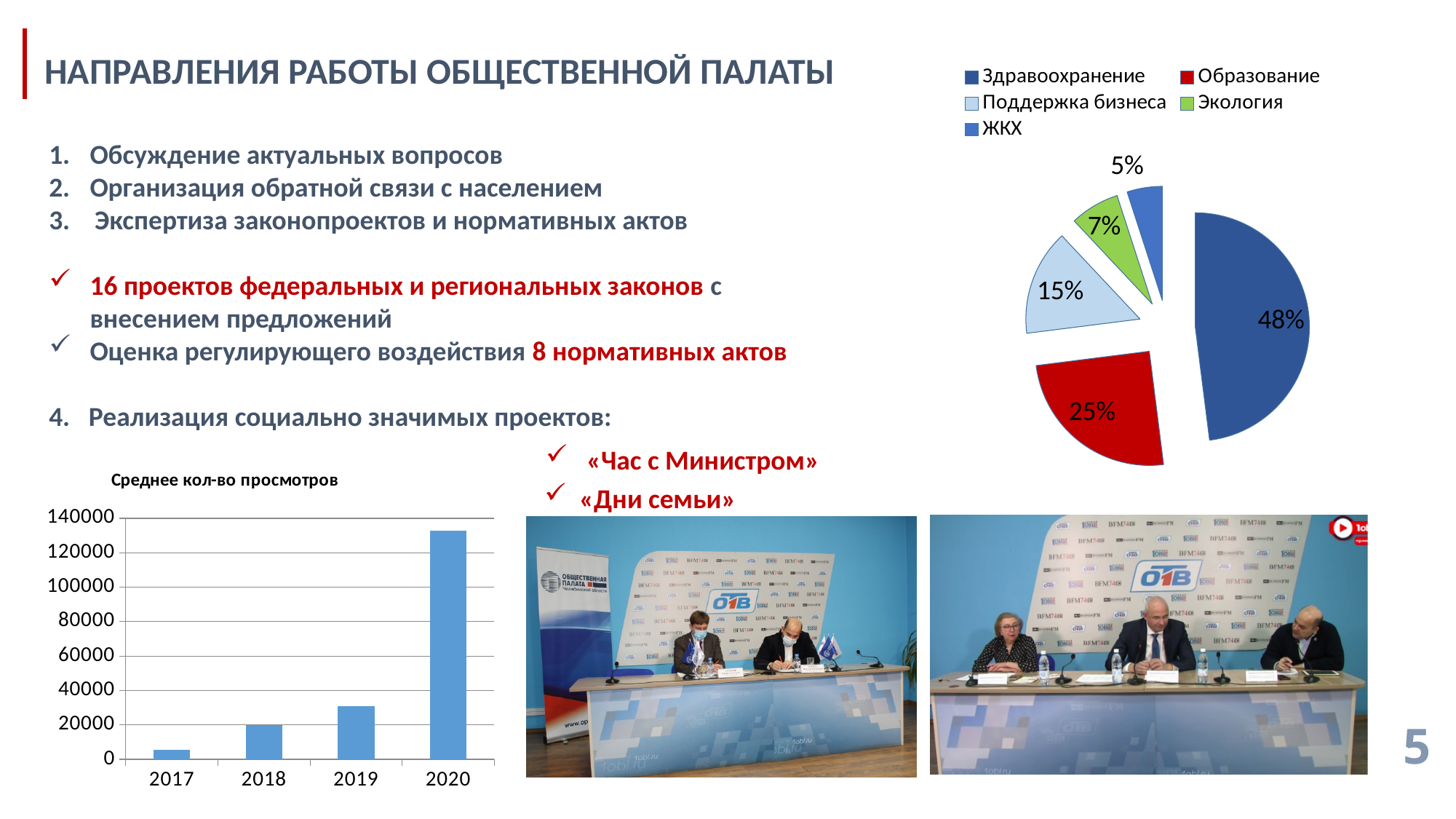
In the pie chart, which category has the largest share? Здравоохранение In the pie chart, which is larger: the share of Экология or the share of ЖКХ? Экология In the chart 'Среднее кол-во просмотров', do the values rise or fall from 2017 to 2020? rise In the pie chart, what share does Поддержка бизнеса have? 15% In the pie chart, which category has the smallest share? ЖКХ In the pie chart, what is the difference between the shares of Здравоохранение and Образование? 23% In the chart 'Среднее кол-во просмотров', which year has the highest value? 2020 How many categories does the pie chart's legend list? 5 What kind of chart is the chart titled 'Среднее кол-во просмотров'? bar chart In the pie chart, what share does Образование have? 25% In the chart 'Среднее кол-во просмотров', is the value for 2020 greater or less than 120000? greater In the pie chart, what share does Здравоохранение have? 48%